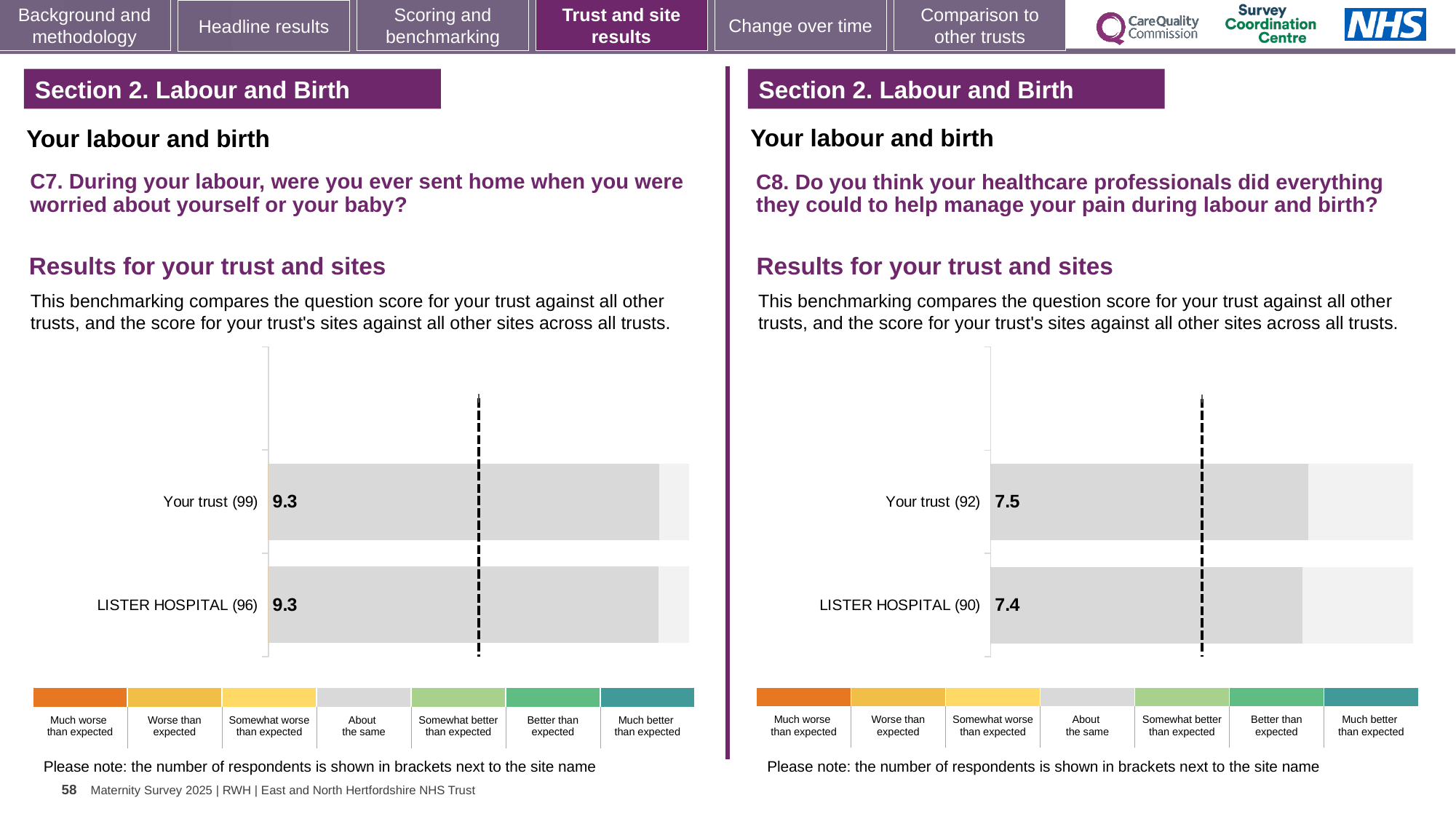
On the C7 chart (left), what is the score for Your trust? 9.3 On the C8 chart (right), what is the score for Your trust? 7.5 How many benchmark categories are shown in the colour key below the C7 chart (left)? 7 On the C8 chart (right), how many respondents are shown in brackets for LISTER HOSPITAL? 90 On the C8 chart (right), what is the score for LISTER HOSPITAL? 7.4 What type of chart is used for the C8 results (right)? Bar chart How many bars are plotted on the C7 chart (left)? 2 On the C8 chart (right), what is the difference between the Your trust score and the LISTER HOSPITAL score? 0.1 On the C7 chart (left), what is the score for LISTER HOSPITAL? 9.3 On the C7 chart (left), what is the difference between the Your trust score and the LISTER HOSPITAL score? 0 On the C8 chart (right), which has the higher score, Your trust or LISTER HOSPITAL? Your trust On the C7 chart (left), how many respondents are shown in brackets for Your trust? 99